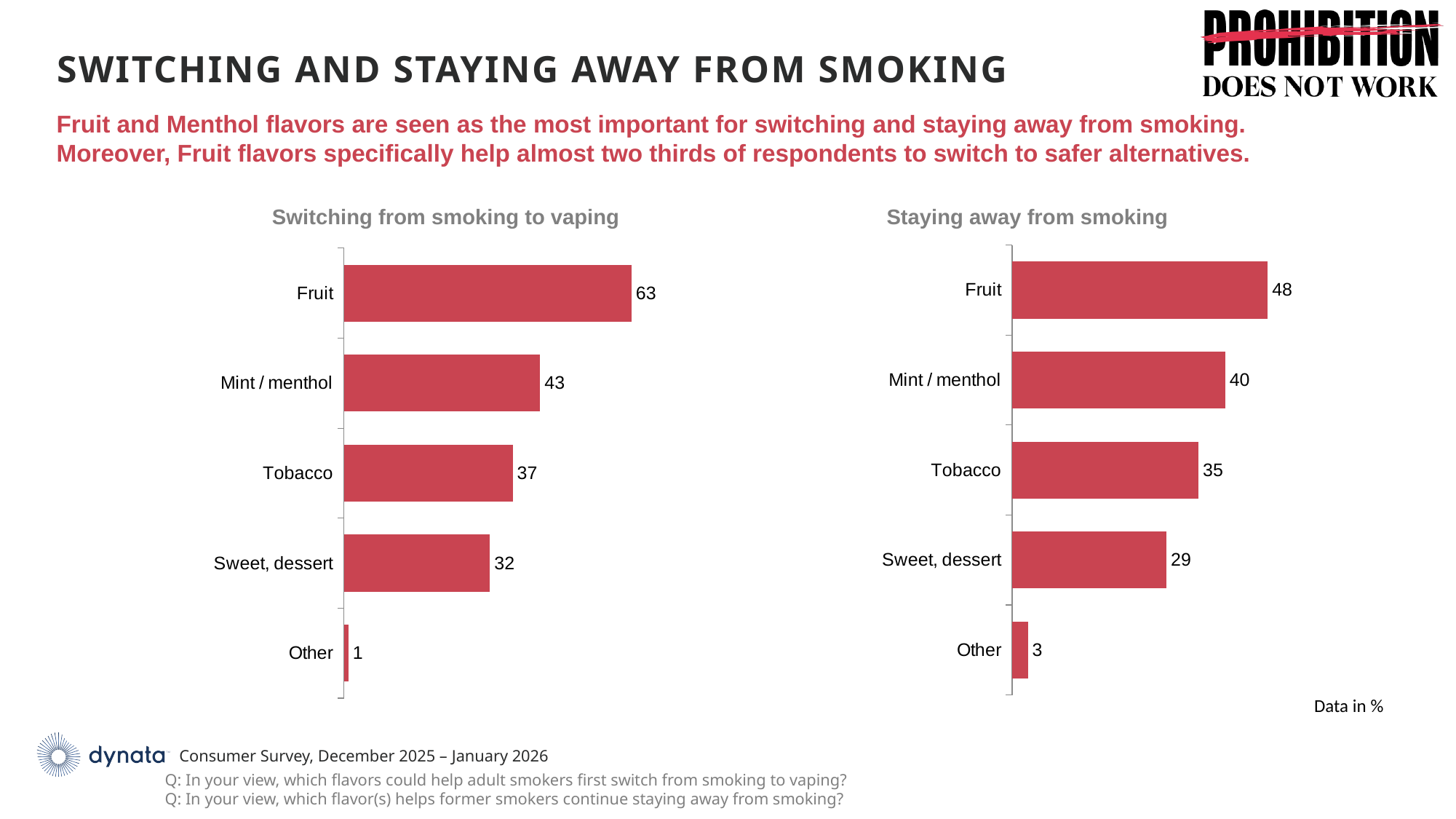
In the 'Staying away from smoking' chart, which category has the lowest value? Other In the 'Staying away from smoking' chart, which is larger: Tobacco or Sweet, dessert? Tobacco In the 'Switching from smoking to vaping' chart, what is the value for Other? 1 In the 'Switching from smoking to vaping' chart, what is the difference between the values for Fruit and Mint / menthol? 20 What unit are the data in the charts expressed in, according to the note on the slide? % In the 'Switching from smoking to vaping' chart, what is the value for Fruit? 63 In the 'Staying away from smoking' chart, what is the value for Mint / menthol? 40 In the 'Staying away from smoking' chart, what is the difference between the values for Tobacco and Sweet, dessert? 6 What type of chart is the 'Staying away from smoking' chart? Bar chart How many categories are shown in the 'Switching from smoking to vaping' chart? 5 Is the value for Fruit larger in the 'Switching from smoking to vaping' chart or in the 'Staying away from smoking' chart? Switching from smoking to vaping In the 'Switching from smoking to vaping' chart, which category has the highest value? Fruit